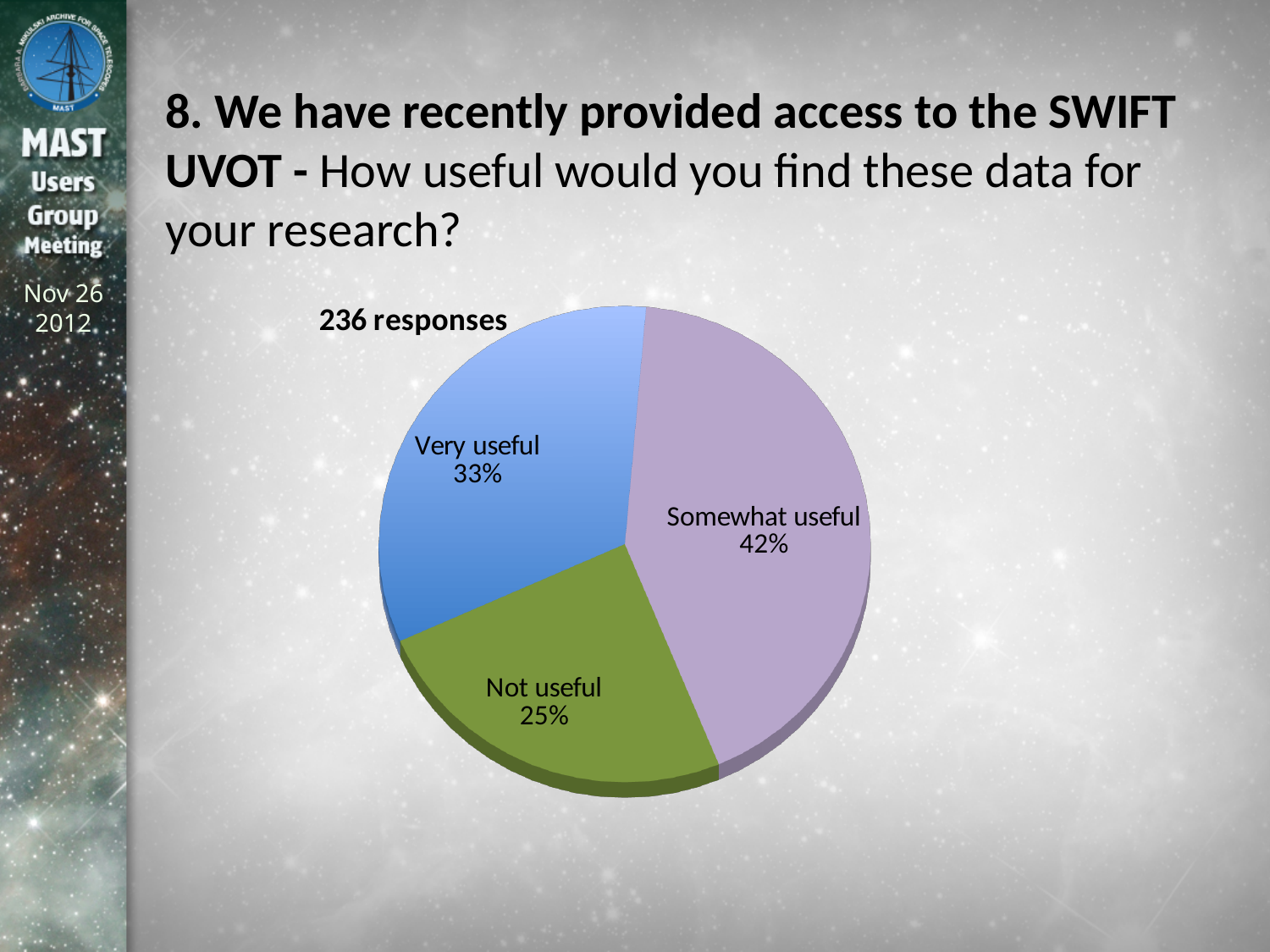
What percentage of respondents said the data would be "Not useful"? 25% How many slices does the pie chart have? 3 Which response category has the smallest share of the pie? Not useful What kind of chart is shown on the slide? Pie chart What is the difference in percentage points between "Very useful" and "Not useful"? 8 How many responses does the chart say it is based on? 236 responses What percentage of respondents said the data would be "Somewhat useful"? 42% What is the difference in percentage points between "Somewhat useful" and "Very useful"? 9 What percentage of respondents said the SWIFT UVOT data would be "Very useful"? 33% Which is larger, the share for "Very useful" or the share for "Not useful"? Very useful What colour is the "Not useful" slice? Green Which response category has the largest share of the pie? Somewhat useful